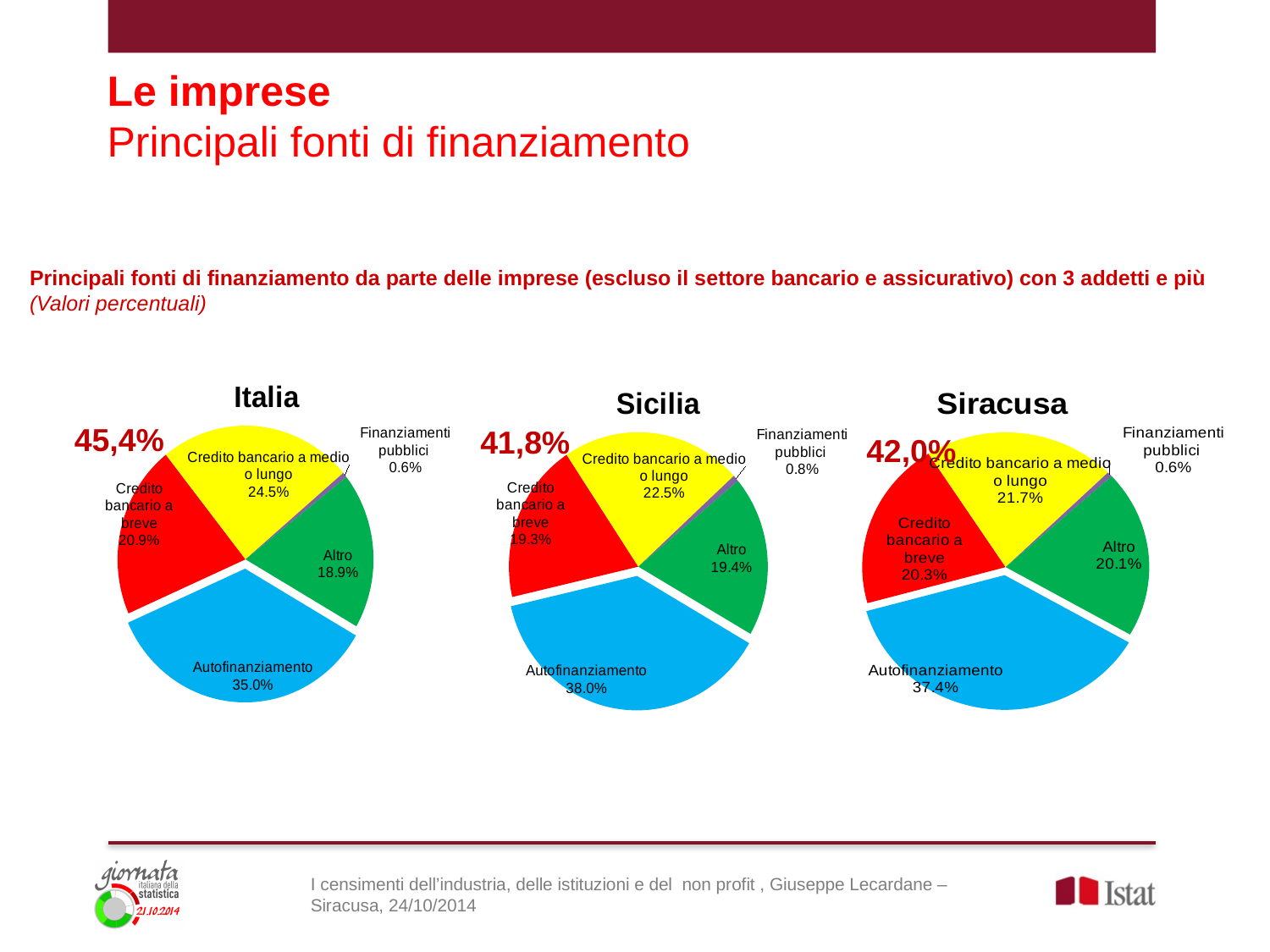
How many pie charts are shown on the slide? 3 In the Sicilia pie chart, what is the share for Credito bancario a medio o lungo? 22.5% What large red percentage is printed next to the Sicilia pie chart? 41,8% In the Italia pie chart, what is the difference between the shares of Autofinanziamento and Altro? 16.1 percentage points In the Siracusa pie chart, what is the share for Finanziamenti pubblici? 0.6% In the Siracusa pie chart, what is the share for Altro? 20.1% In the Sicilia pie chart, which is larger: Credito bancario a breve or Altro? Altro In the Siracusa pie chart, which category has the largest share? Autofinanziamento In the Italia pie chart, what is the share for Autofinanziamento? 35.0% What type of chart is used for Siracusa? Pie chart How many slices does the Italia pie chart have? 5 In the Sicilia pie chart, which category has the smallest share? Finanziamenti pubblici